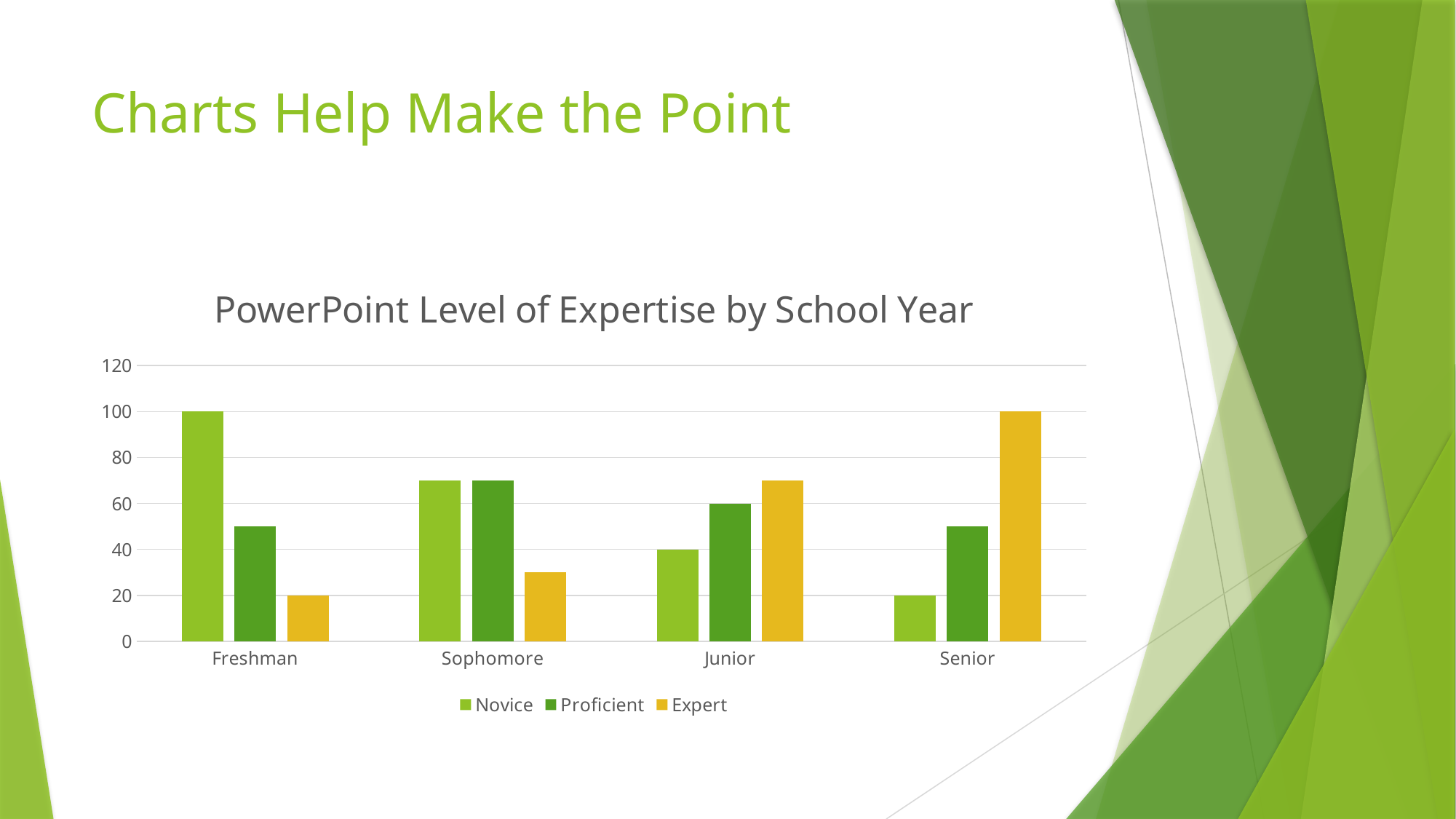
What is the Proficient value for Junior? 60 What is the Novice value for Senior? 20 Do the Expert values rise or fall from Freshman to Senior? rise For Junior, which is larger, the Novice value or the Expert value? Expert What is the difference between the Novice and Expert values for Freshman? 80 What is the Expert value for Senior? 100 Is the Novice value for Sophomore greater or less than 60? greater Which school year has the highest Novice value? Freshman How many series does the legend list? 3 Which school year has the lowest Expert value? Freshman What is the Novice value for Freshman? 100 How many school years are shown on the x axis? 4